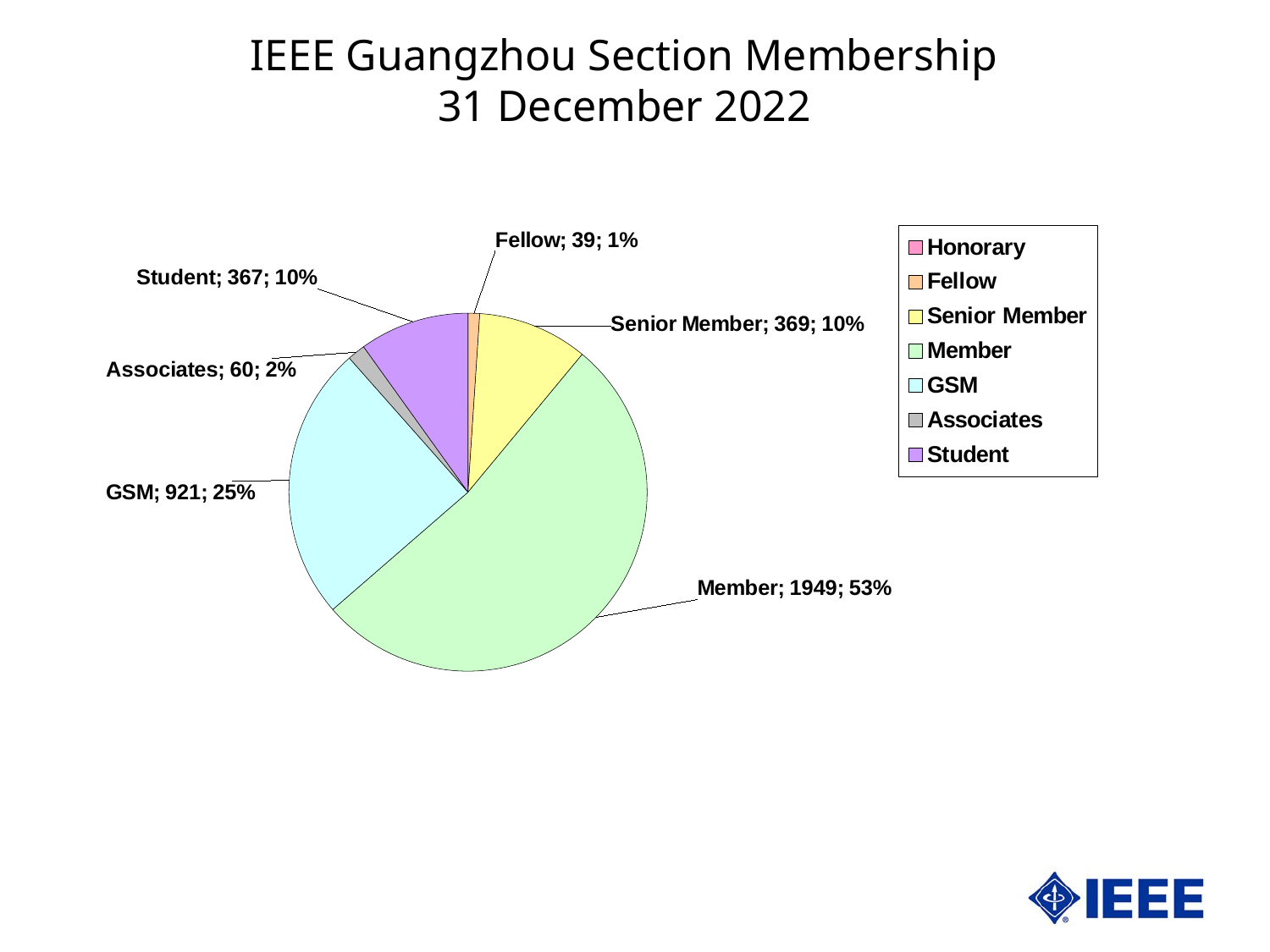
Which is larger, the GSM count or the Student count? GSM Which labelled category has the smallest slice of the pie? Fellow How many members are in the Member category? 1949 Which category has the largest slice of the pie? Member What share of the pie does the Member slice represent? 53% What is the value for Fellow? 39 What percentage of the membership is GSM? 25% What type of chart is shown on the slide? pie chart What is the title of the slide containing the chart? IEEE Guangzhou Section Membership 31 December 2022 What is the difference between the Member count and the GSM count? 1028 How many entries does the legend list? 7 How many members are in the Senior Member category? 369